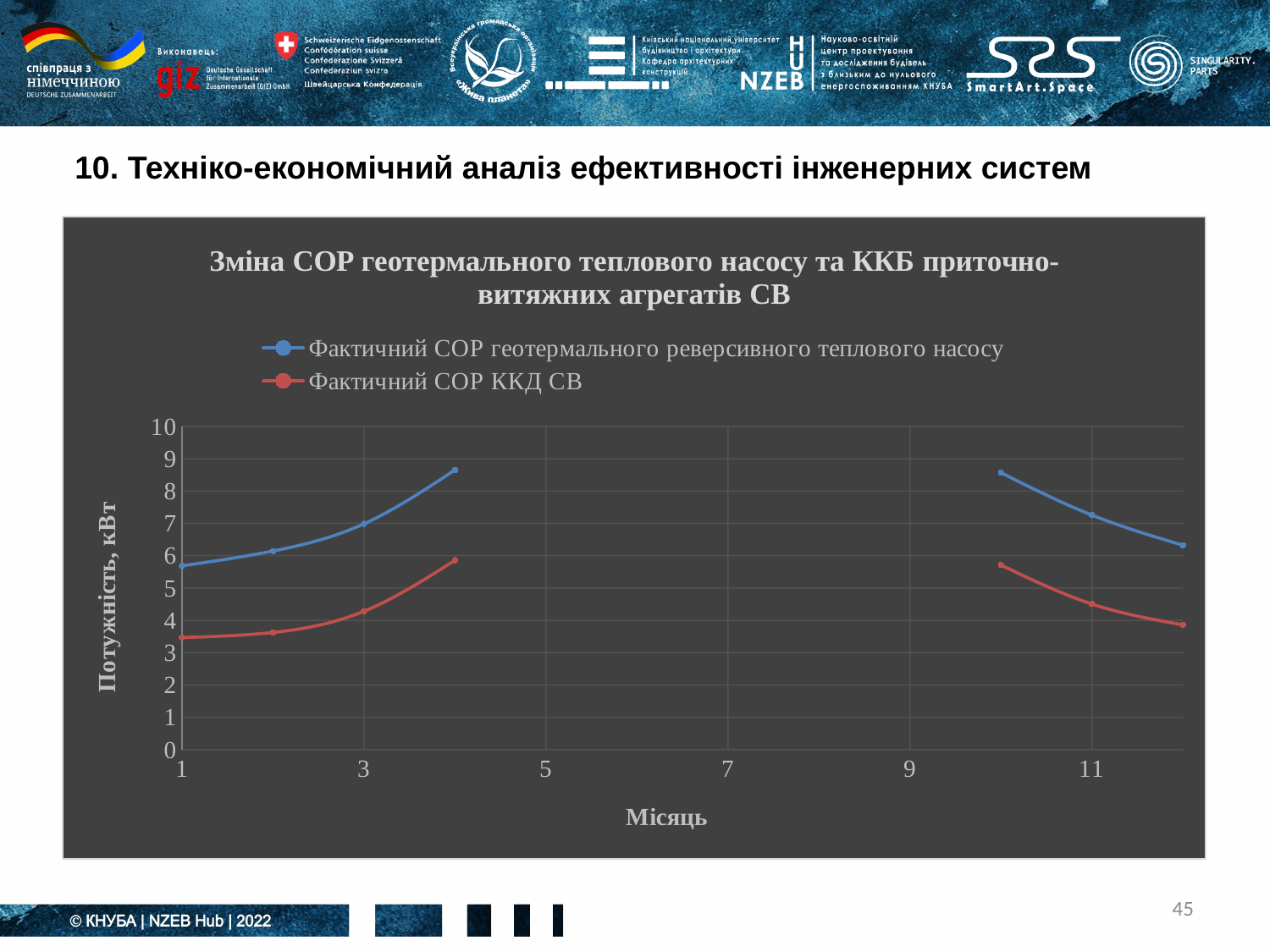
Do the values of 'Фактичний COP геотермального реверсивного теплового насосу' rise or fall from month 10 to month 12? fall How many series does the legend list? 2 Do the values of 'Фактичний COP ККД СВ' rise or fall from month 1 to month 4? rise What is the title of the y axis? Потужність, кВт Is the value for 'Фактичний COP ККД СВ' at month 1 greater or less than 4? less How many data points are plotted for the 'Фактичний COP ККД СВ' series? 7 Is the value for 'Фактичний COP ККД СВ' at month 12 greater or less than 5? less What is the title of the x axis? Місяць Is the value for 'Фактичний COP геотермального реверсивного теплового насосу' at month 4 greater or less than 8? greater What kind of chart is shown on the slide? line chart At month 11, which series has the larger value: 'Фактичний COP геотермального реверсивного теплового насосу' or 'Фактичний COP ККД СВ'? Фактичний COP геотермального реверсивного теплового насосу